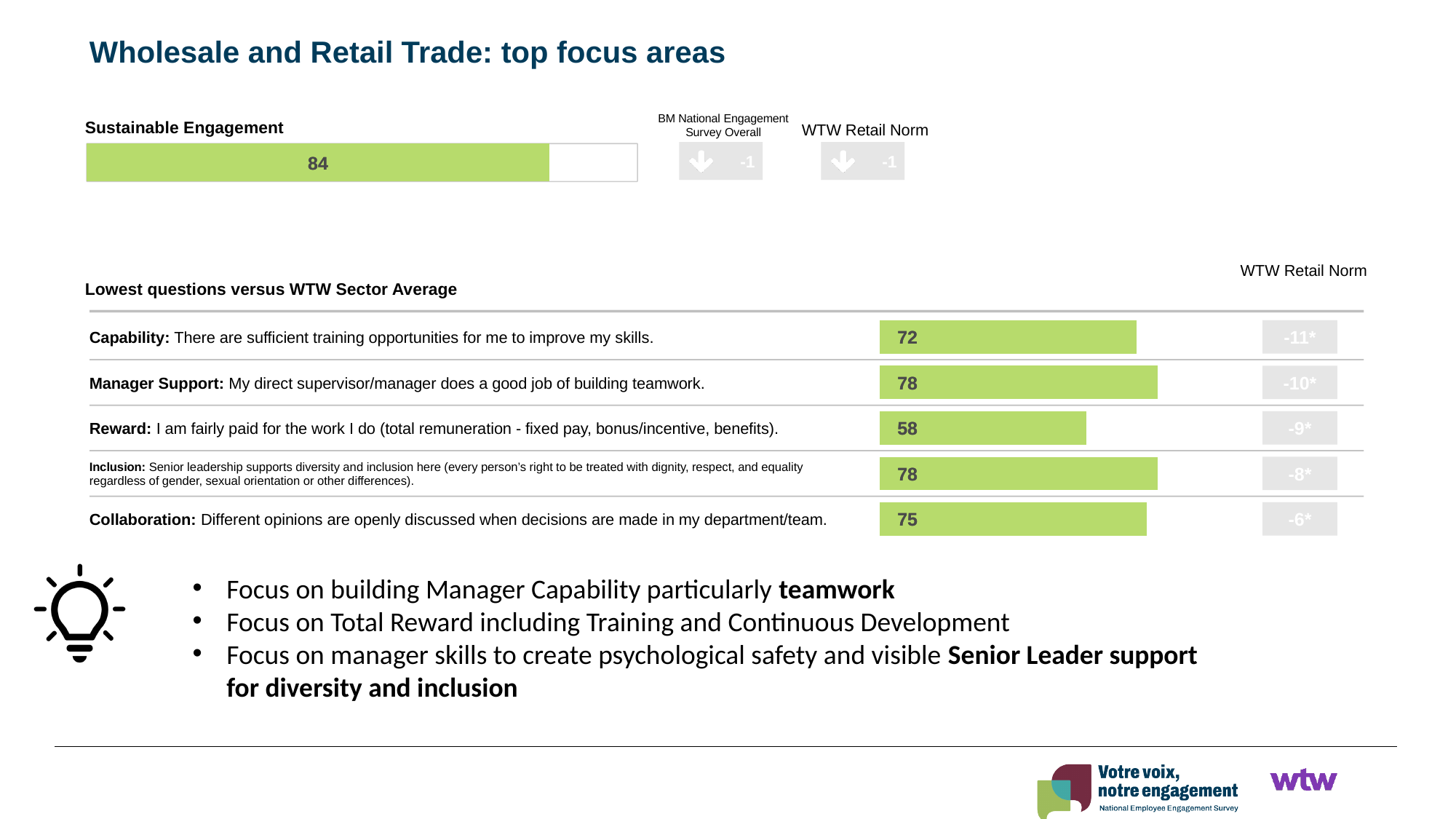
In the Lowest questions versus WTW Sector Average chart, which is larger, the Capability score or the Collaboration score? Collaboration How many questions are listed in the Lowest questions versus WTW Sector Average chart? 5 In the Sustainable Engagement bar at the top of the slide, what value is shown? 84 In the Lowest questions versus WTW Sector Average chart, what is the value for Collaboration? 75 In the Lowest questions versus WTW Sector Average chart, which question has the lowest score? Reward In the Lowest questions versus WTW Sector Average chart, what is the WTW Retail Norm difference shown for Collaboration? -6* In the Lowest questions versus WTW Sector Average chart, what is the difference between the Manager Support score and the Reward score? 20 In the Lowest questions versus WTW Sector Average chart, what is the value for Reward? 58 In the Lowest questions versus WTW Sector Average chart, what is the WTW Retail Norm difference shown for Capability? -11* What kind of chart is used to show the scores in the Lowest questions versus WTW Sector Average section? Bar chart In the Sustainable Engagement section, what is the difference shown versus the WTW Retail Norm? -1 In the Lowest questions versus WTW Sector Average chart, what is the value for Capability? 72